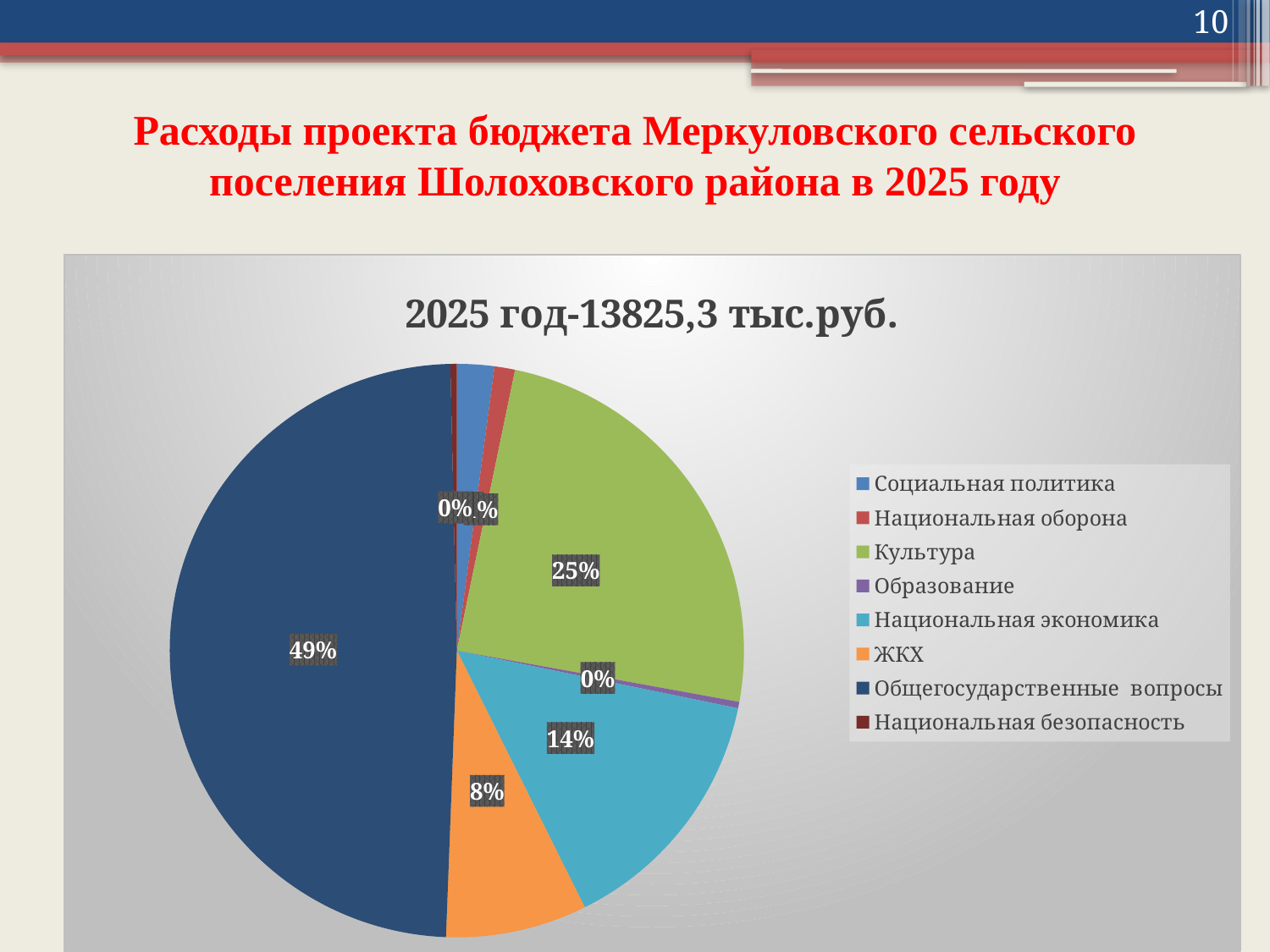
What is the title of the chart? 2025 год-13825,3 тыс.руб. What share of the pie is Образование? 0% Which category has the largest share of the pie? Общегосударственные вопросы What colour is the slice for Культура? green Which is larger, the share for Культура or the share for Национальная экономика? Культура What share of the pie is Культура? 25% By how many percentage points does the share for Общегосударственные вопросы exceed the share for Культура? 24 How many categories does the chart legend list? 8 What share of the pie is ЖКХ? 8% What kind of chart is shown on the slide? pie chart What share of the pie is Национальная экономика? 14% What share of the pie is Общегосударственные вопросы? 49%